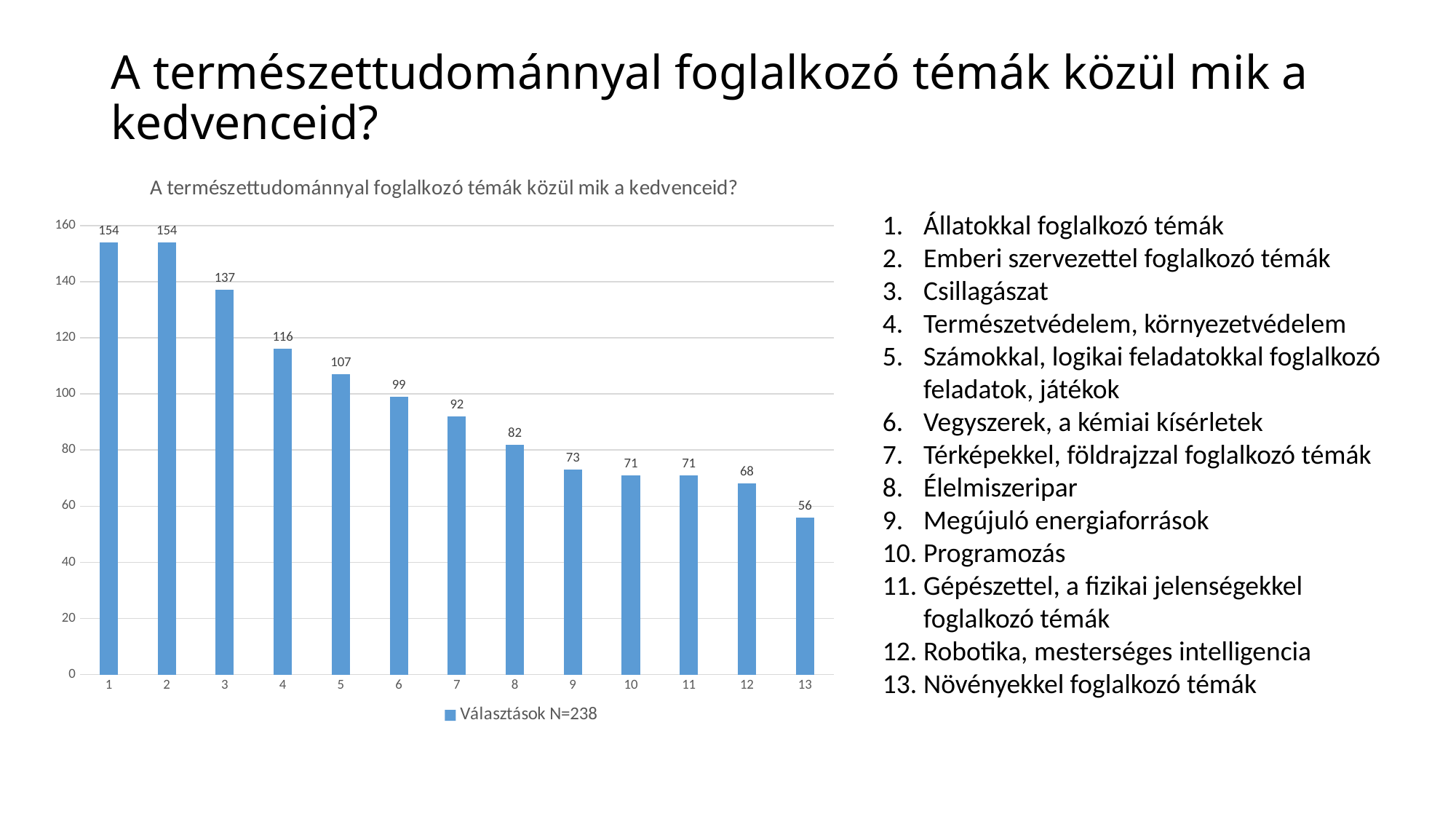
What kind of chart is shown? bar chart What is the value for category 13? 56 What is the value for category 8? 82 Is the value for category 12 greater or less than 80? less Do the values rise or fall from category 1 to category 13? fall How many series does the legend list? 1 Which category has the lowest value? 13 How many categories are shown on the x axis? 13 What is the value for category 3? 137 What is the difference between the values for category 1 and category 4? 38 Which is larger, the value for category 5 or the value for category 7? category 5 What is the difference between the values for category 6 and category 9? 26